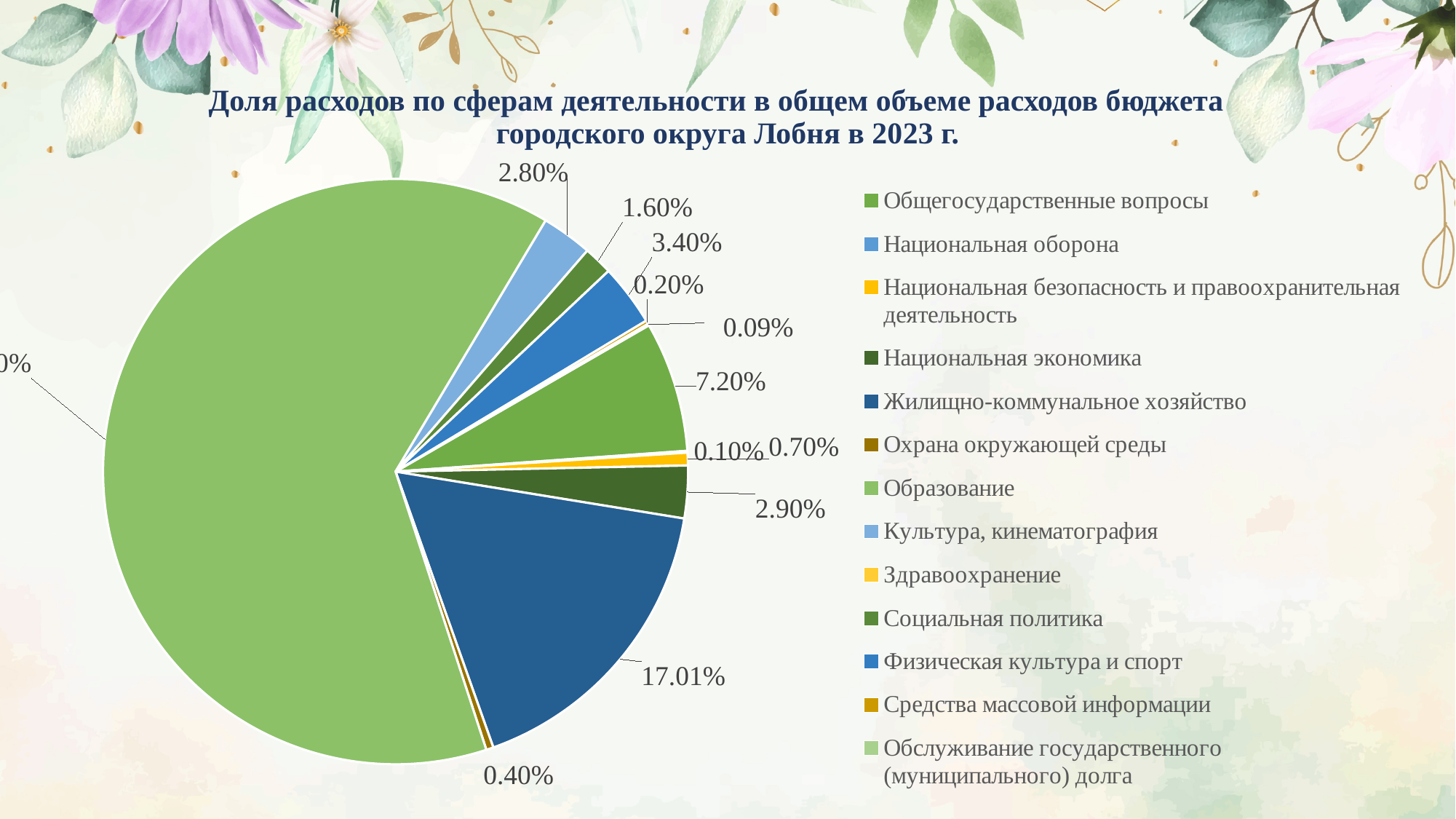
What year does the chart title refer to? 2023 Which is larger: the share for Образование or the share for Жилищно-коммунальное хозяйство? Образование What share is shown for Общегосударственные вопросы? 7.20% What is the difference between the share for Жилищно-коммунальное хозяйство (17.01%) and the share for Общегосударственные вопросы (7.20%)? 9.81% How many categories does the legend of the pie chart list? 13 Is the share for Образование greater or less than 50%? greater Which city district (городской округ) is named in the chart title? Лобня Which category has the largest share of the pie? Образование What kind of chart is shown on the slide? pie chart What share is shown for Жилищно-коммунальное хозяйство? 17.01% What is the smallest percentage printed as a data label on the pie chart? 0.09%